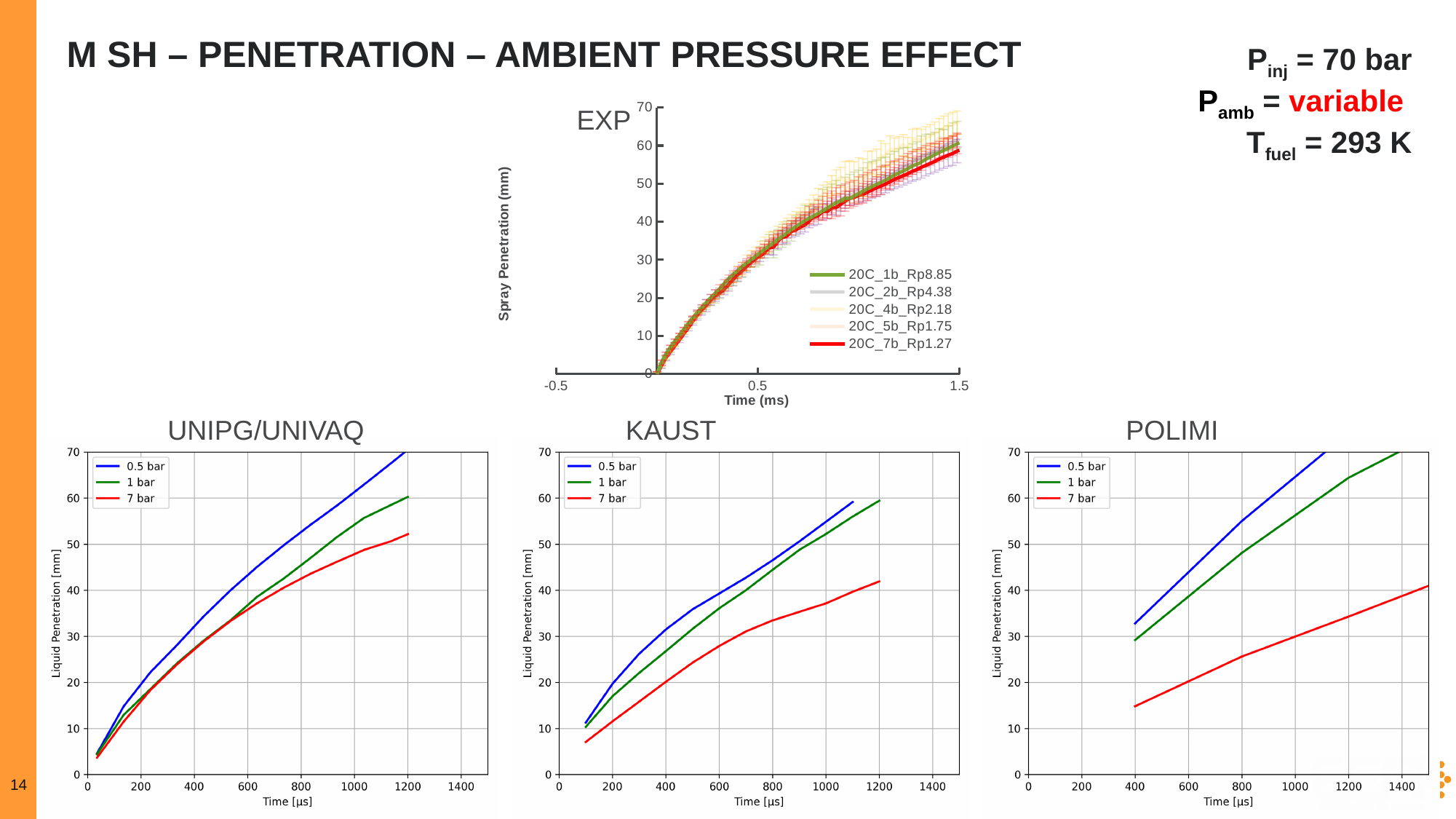
What kind of chart is the KAUST chart? line chart In the EXP chart, which legend entry is drawn in red? 20C_7b_Rp1.27 In the UNIPG/UNIVAQ chart, at 1200 µs, which is higher: the 0.5 bar line or the 7 bar line? 0.5 bar In the KAUST chart, is the 0.5 bar value at 1000 µs greater or less than 50? greater What is the x-axis label of the EXP chart? Time (ms) In the UNIPG/UNIVAQ chart, is the 7 bar value at 1200 µs greater or less than 60? less In the EXP chart at the top, how many series does the legend list? 5 In the POLIMI chart, does the 7 bar line rise or fall as time increases? rises In the POLIMI chart, which series is lowest at 1400 µs? 7 bar In the KAUST chart, is the 7 bar value at 1200 µs greater or less than 50? less In the UNIPG/UNIVAQ chart, how many series does the legend list? 3